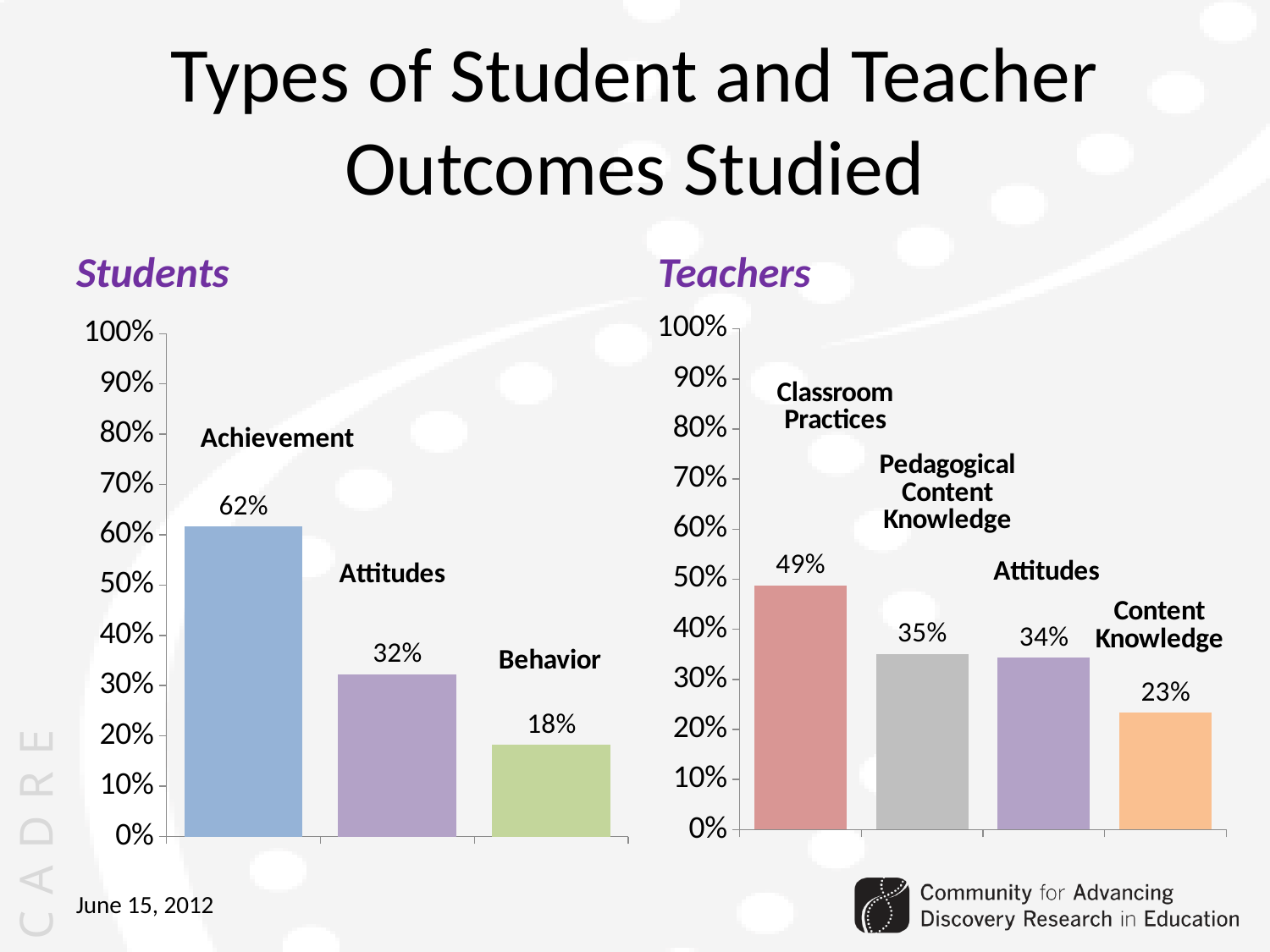
In the Students chart, which category has the highest value? Achievement In the Students chart, what is the value for Behavior? 18% In the Teachers chart, which category has the lowest value? Content Knowledge In the Teachers chart, what is the value for Content Knowledge? 23% In the Students chart, what is the value for Achievement? 62% In the Teachers chart, what is the difference between Classroom Practices and Pedagogical Content Knowledge? 14% What kind of chart is the Students chart? Bar chart Which is larger: Attitudes in the Students chart or Attitudes in the Teachers chart? Attitudes in the Teachers chart How many categories are shown in the Students chart? 3 In the Teachers chart, what is the value for Classroom Practices? 49% How many categories are shown in the Teachers chart? 4 In the Students chart, what is the difference between Achievement and Attitudes? 30%